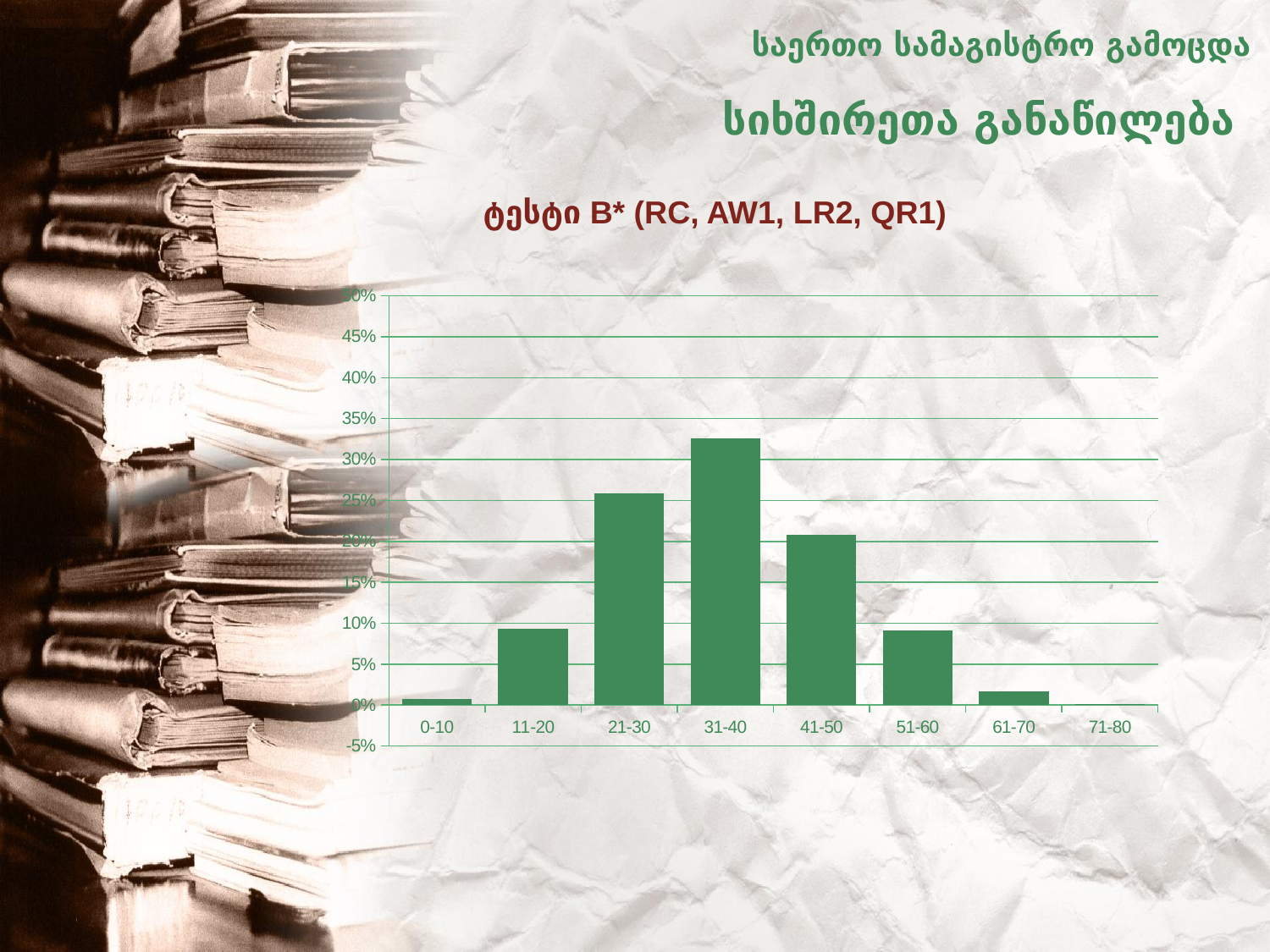
Do the values rise or fall from 31-40 to 71-80 along the x axis? fall Is the value for 31-40 greater or less than 30%? greater What is the title of the chart? ტესტი B* (RC, AW1, LR2, QR1) Which score range has the lowest bar? 71-80 Is the value for 21-30 greater or less than 20%? greater Which is larger, the value for 21-30 or the value for 41-50? 21-30 How many score-range categories are shown on the x axis? 8 Which score range has the highest bar? 31-40 Is the value for 41-50 greater or less than 25%? less What kind of chart is shown on the slide? bar chart